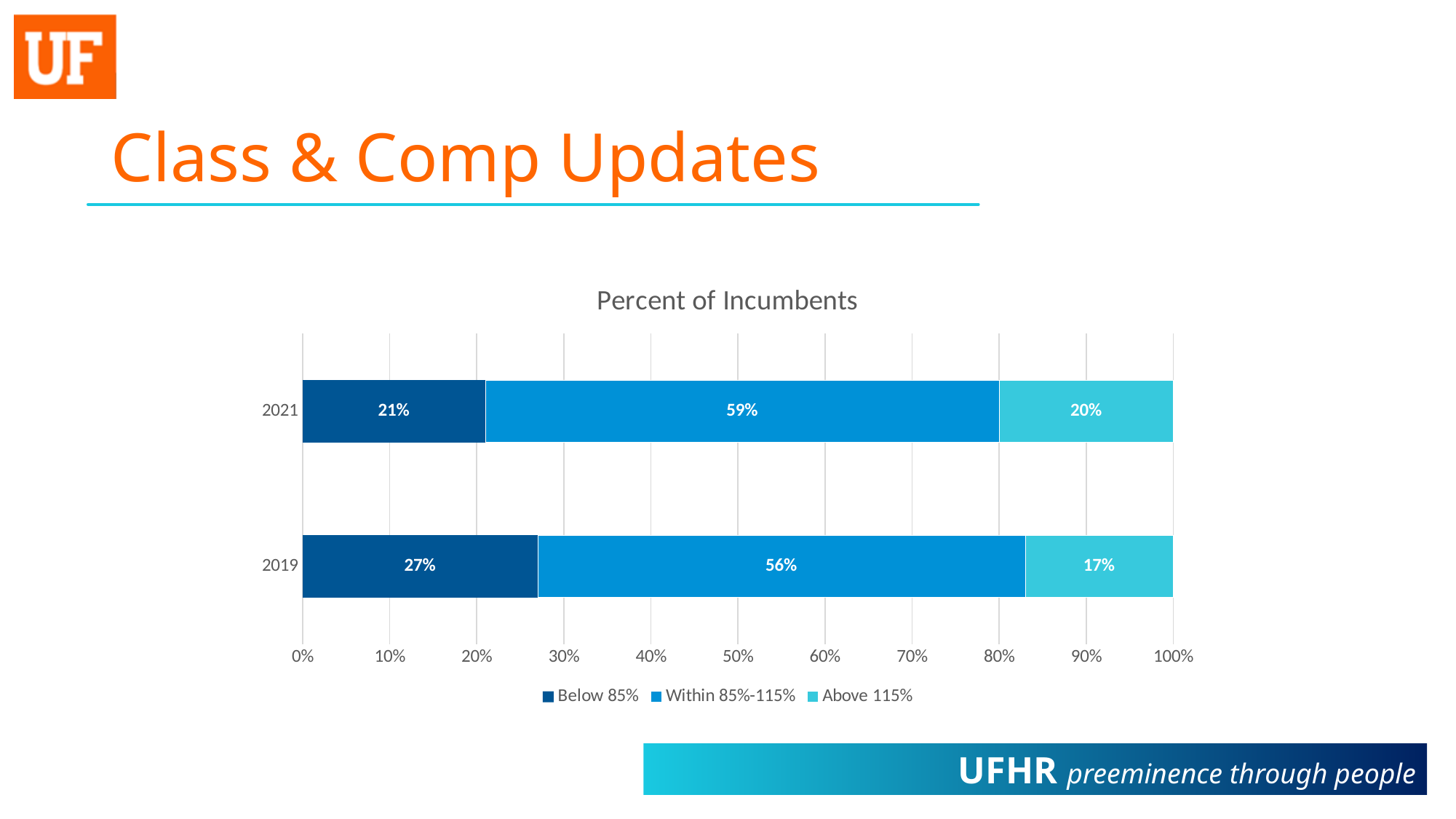
What is the difference between the Below 85% values for 2019 and 2021? 6% How many categories (years) are shown on the chart? 2 What is the title of the chart? Percent of Incumbents Which series has the smallest value in 2019? Above 115% Which year has the larger Above 115% value, 2019 or 2021? 2021 What kind of chart is shown on the slide? Stacked bar chart What is the value for Above 115% in 2021? 20% How many series does the legend list? 3 Which series has the largest value in 2021? Within 85%-115% What is the value for Within 85%-115% in 2019? 56% What is the value for Below 85% in 2019? 27% What is the value for Below 85% in 2021? 21%